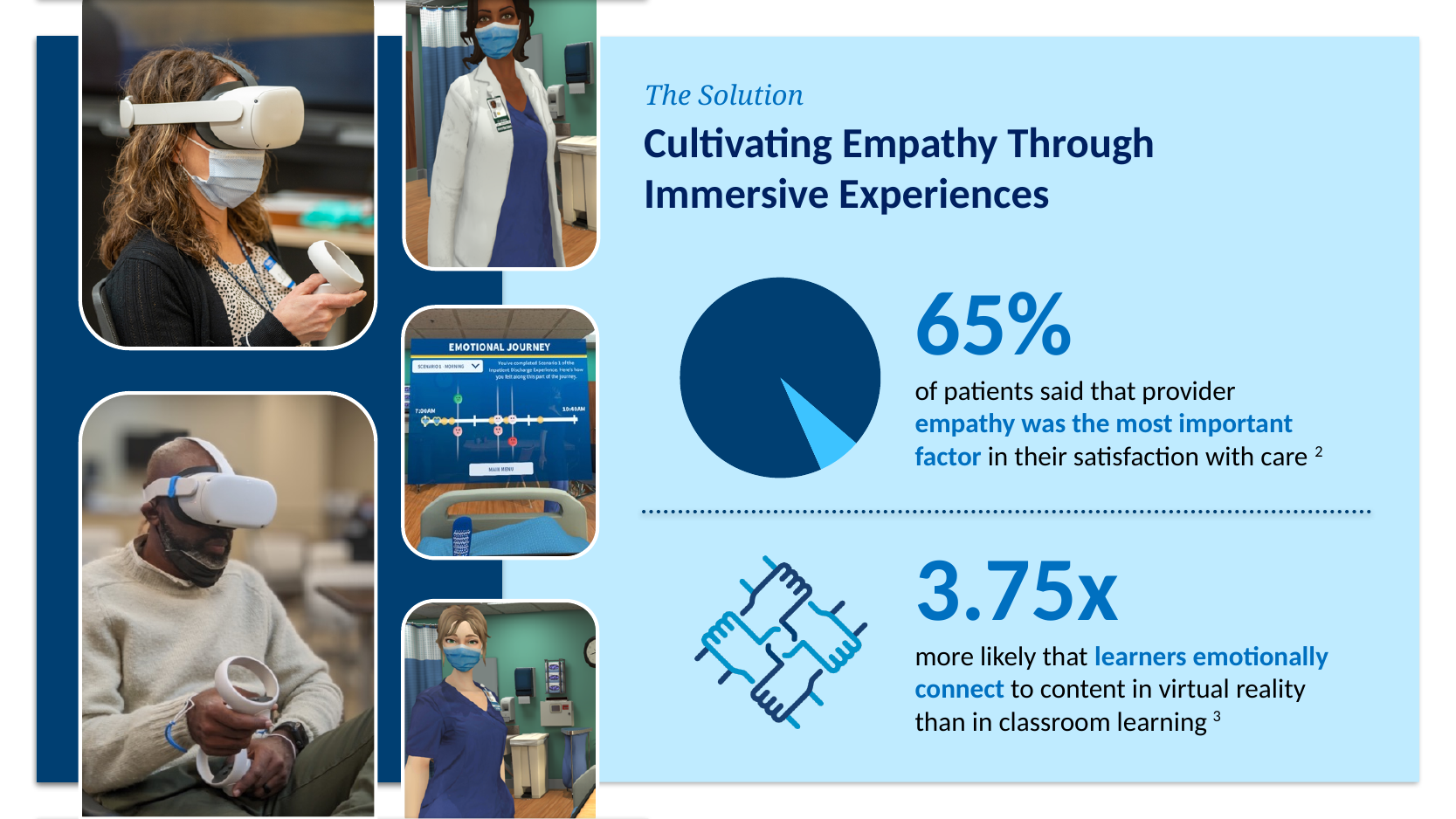
Is the share of the pie chart taken by the light blue slice greater or less than 50%? less Which slice of the pie chart is larger, the dark blue slice or the light blue slice? dark blue What percentage is printed beside the pie chart? 65% What kind of chart is shown next to the 65% statistic? pie chart According to the text beside the pie chart, what did 65% of patients say was the most important factor in their satisfaction with care? provider empathy Is the share of the pie chart taken by the dark blue slice greater or less than 50%? greater What is the title of the slide containing the pie chart? Cultivating Empathy Through Immersive Experiences Which slice of the pie chart is the smallest? light blue How many slices does the pie chart have? 2